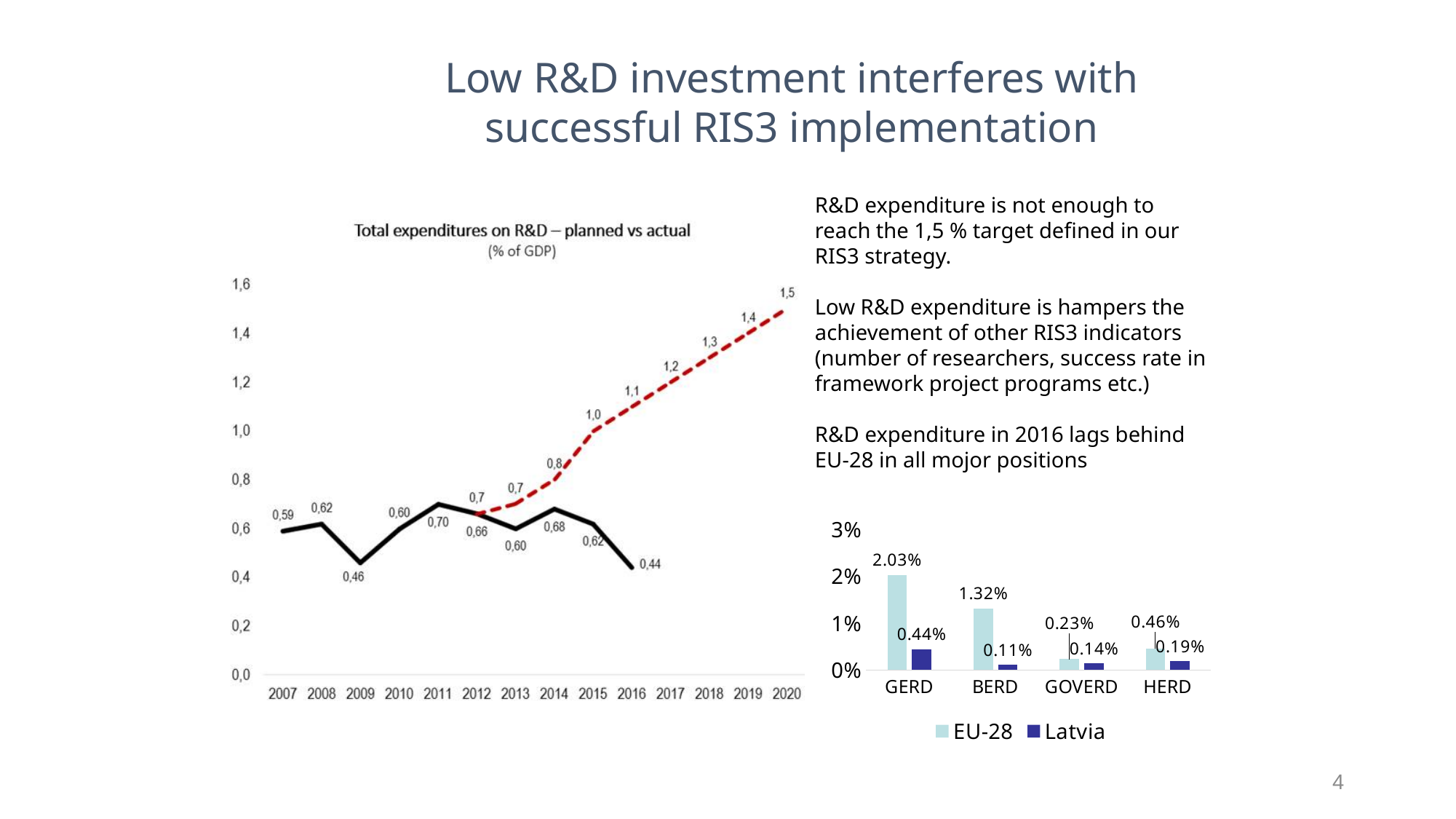
What kind of chart is the chart titled 'Total expenditures on R&D – planned vs actual'? line chart In the bar chart on the right, which category has the lowest EU-28 value? GOVERD In the chart titled 'Total expenditures on R&D – planned vs actual', what is the difference between the planned and actual values for 2016? 0,66 In the bar chart on the right, how many categories are shown on the x axis? 4 In the chart titled 'Total expenditures on R&D – planned vs actual', does the planned (dashed) line rise or fall from 2012 to 2020? rise In the chart titled 'Total expenditures on R&D – planned vs actual', what is the planned value for 2020? 1,5 In the bar chart on the right, what is the Latvia value for BERD? 0.11% In the bar chart on the right, how many series does the legend list? 2 In the bar chart on the right, what is the EU-28 value for GERD? 2.03% In the chart titled 'Total expenditures on R&D – planned vs actual', what is the actual value for 2016? 0,44 In the bar chart on the right, what is the difference between the EU-28 and Latvia values for HERD? 0.27% In the chart titled 'Total expenditures on R&D – planned vs actual', which year has the highest actual value? 2011